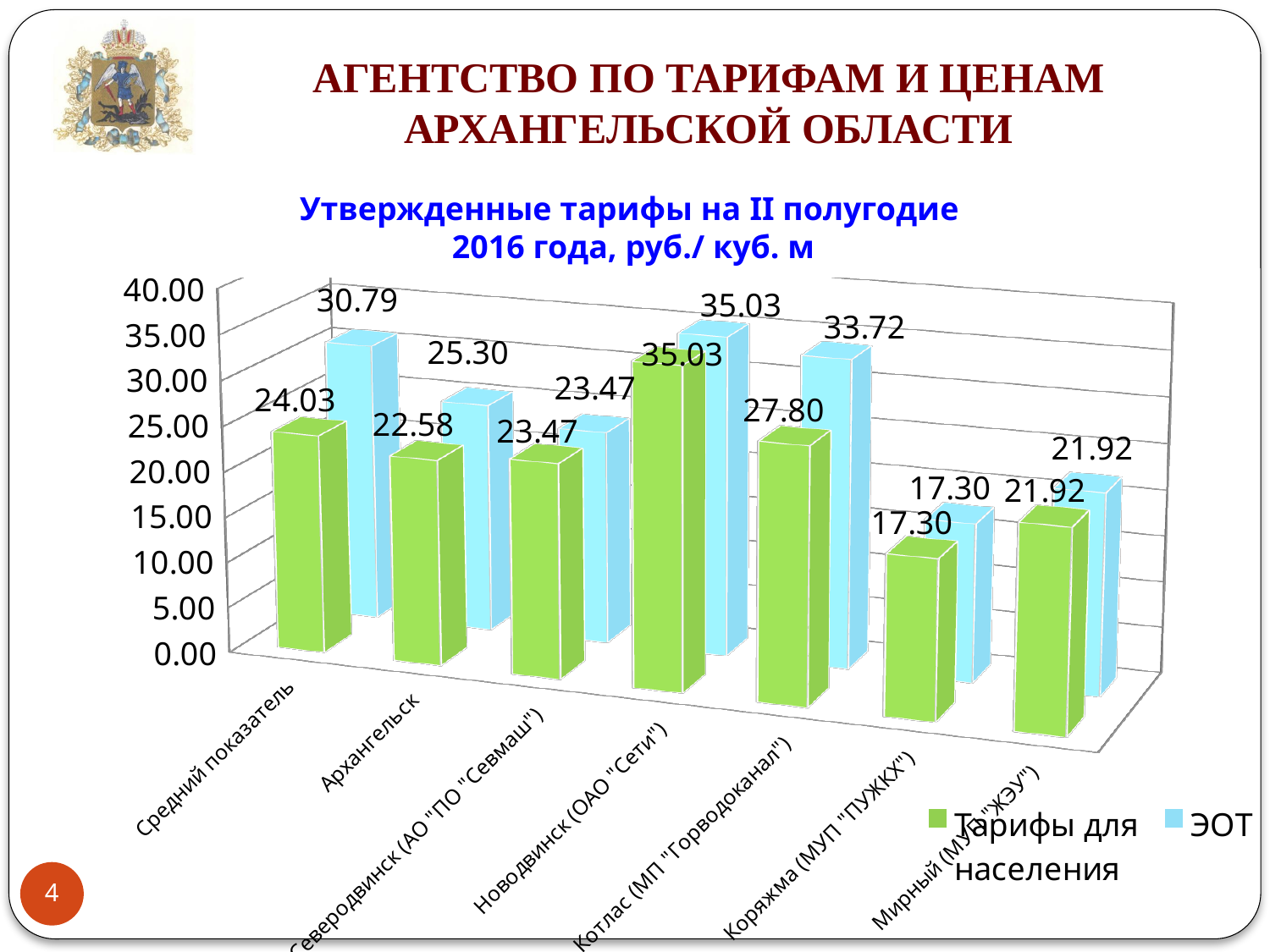
Which category has the lowest ЭОТ value? Коряжма (МУП "ПУЖКХ") Which is larger for Архангельск: Тарифы для населения or ЭОТ? ЭОТ How many series does the legend list? 2 What type of chart is shown on the slide? Bar chart What is the ЭОТ value for Средний показатель? 30.79 What is the value of Тарифы для населения for Архангельск? 22.58 What is the difference between the ЭОТ value and the Тарифы для населения value for Котлас (МП "Горводоканал")? 5.92 How many categories are shown on the x axis? 7 What is the difference between the ЭОТ value and the Тарифы для населения value for Средний показатель? 6.76 What is the ЭОТ value for Котлас (МП "Горводоканал")? 33.72 Which category has the highest Тарифы для населения value? Новодвинск (ОАО "Сети") What is the value of Тарифы для населения for Коряжма (МУП "ПУЖКХ")? 17.30